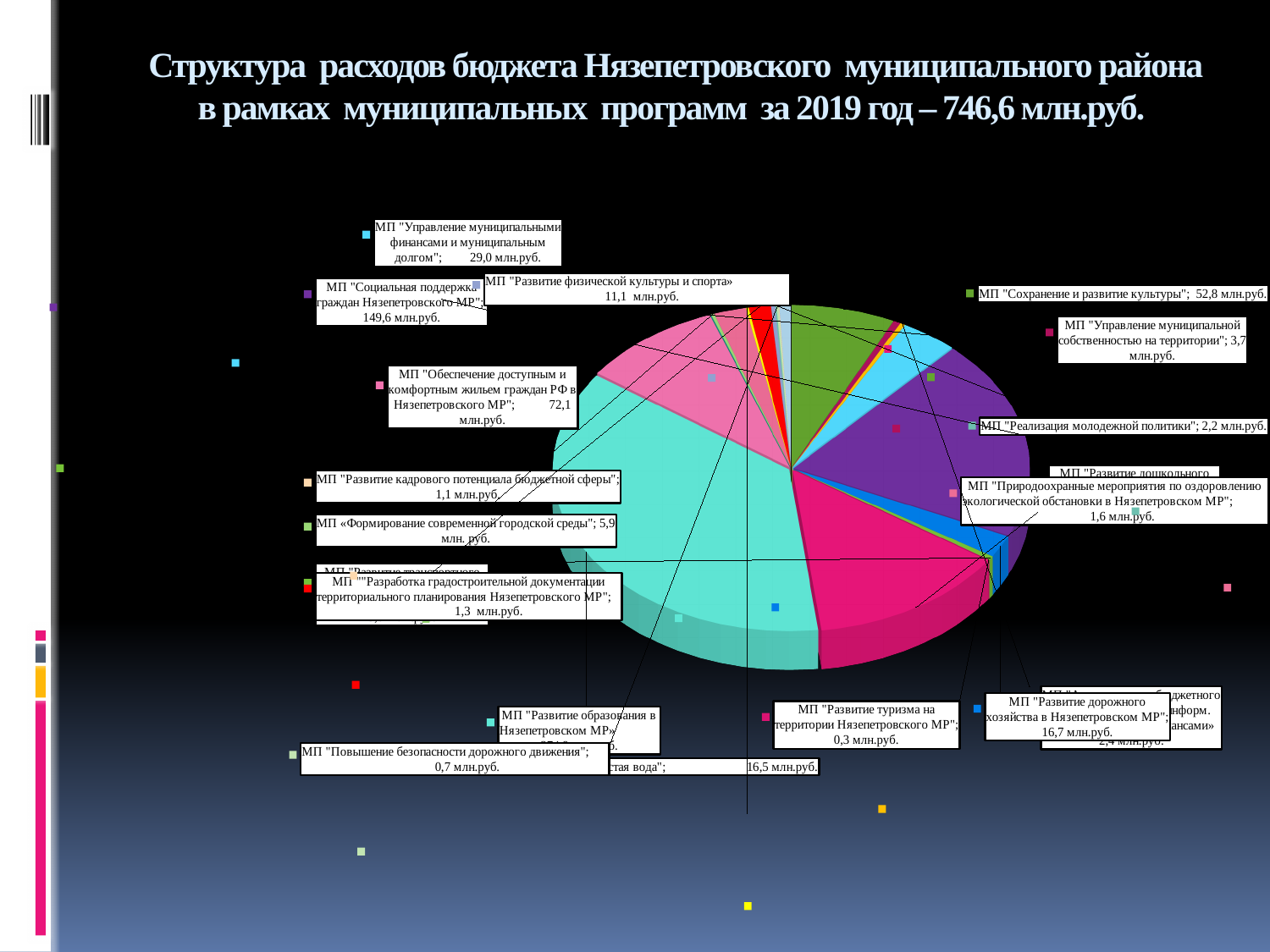
What is the value for МП "Развитие дорожного хозяйства в Нязепетровском МР"? 16,7 млн.руб. What is the value for МП "Социальная поддержка граждан Нязепетровского МР"? 149,6 млн.руб. What is the value for МП "Развитие туризма на территории Нязепетровского МР"? 0,3 млн.руб. Which program has the largest slice of the pie? МП "Развитие образования в Нязепетровском МР» What kind of chart is shown on the slide? pie chart Which program has the smallest labelled value? МП "Развитие туризма на территории Нязепетровского МР" Which is larger: МП "Сохранение и развитие культуры" or МП "Управление муниципальными финансами и муниципальным долгом"? МП "Сохранение и развитие культуры" What is the value for МП "Реализация молодежной политики"? 2,2 млн.руб. According to the chart title, what is the total expenditure under municipal programs for 2019? 746,6 млн.руб. What is the difference between МП "Социальная поддержка граждан Нязепетровского МР" and МП "Обеспечение доступным и комфортным жильем граждан РФ в Нязепетровского МР"? 77,5 млн.руб. What is the value for МП "Сохранение и развитие культуры"? 52,8 млн.руб. What is the value for МП "Управление муниципальными финансами и муниципальным долгом"? 29,0 млн.руб.